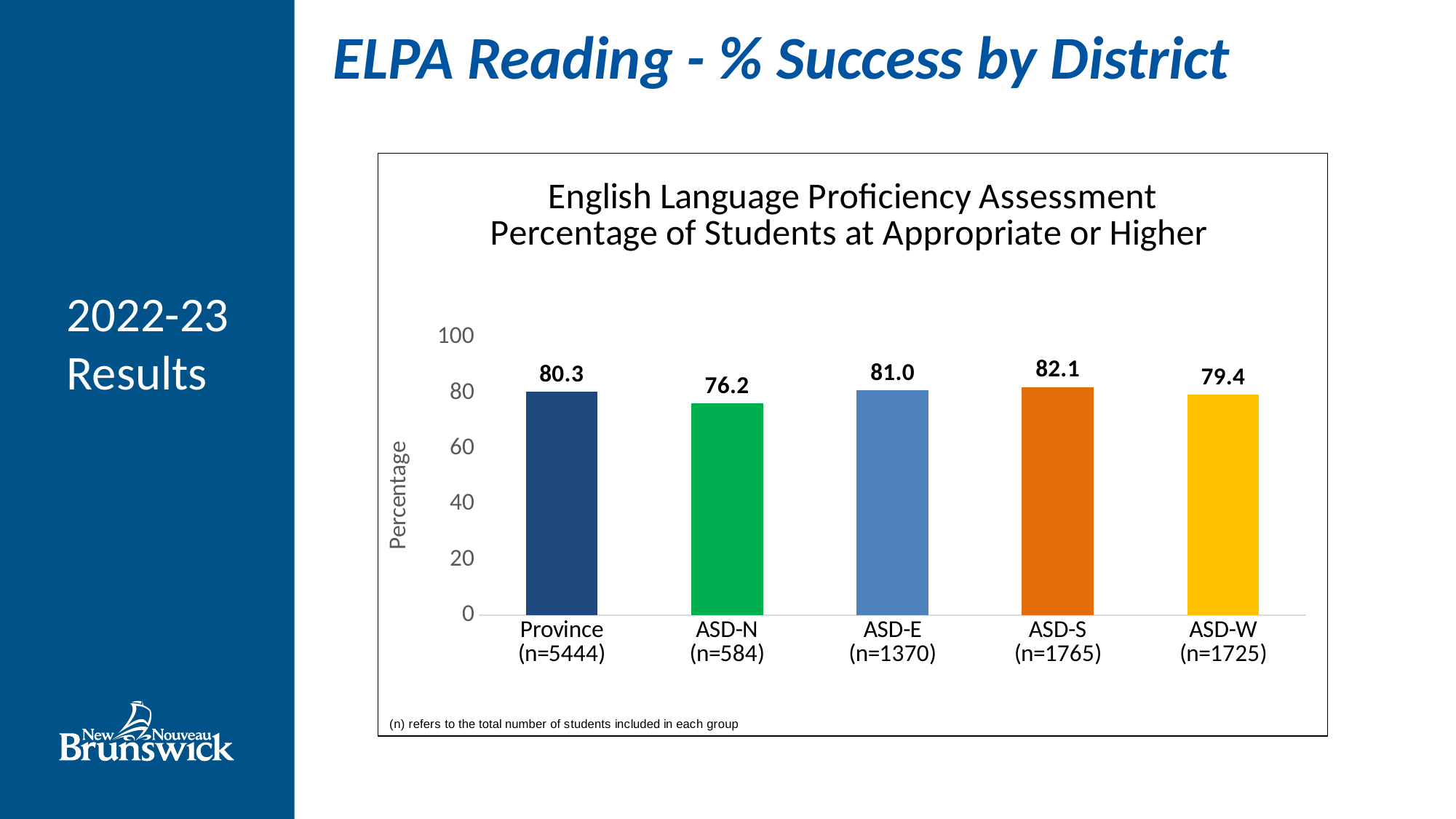
What is the label on the y axis? Percentage What is the difference between the values for ASD-E and Province? 0.7 What is the difference between the values for ASD-S and ASD-N? 5.9 What is the value for ASD-N? 76.2 Is the value for ASD-N greater or less than 80? less What is the value for Province? 80.3 Which district has the highest percentage? ASD-S Which category has the lowest percentage? ASD-N What is the value for ASD-W? 79.4 What kind of chart is shown on the slide? bar chart How many categories are shown on the x axis? 5 Which is larger, the value for ASD-E or the value for ASD-W? ASD-E